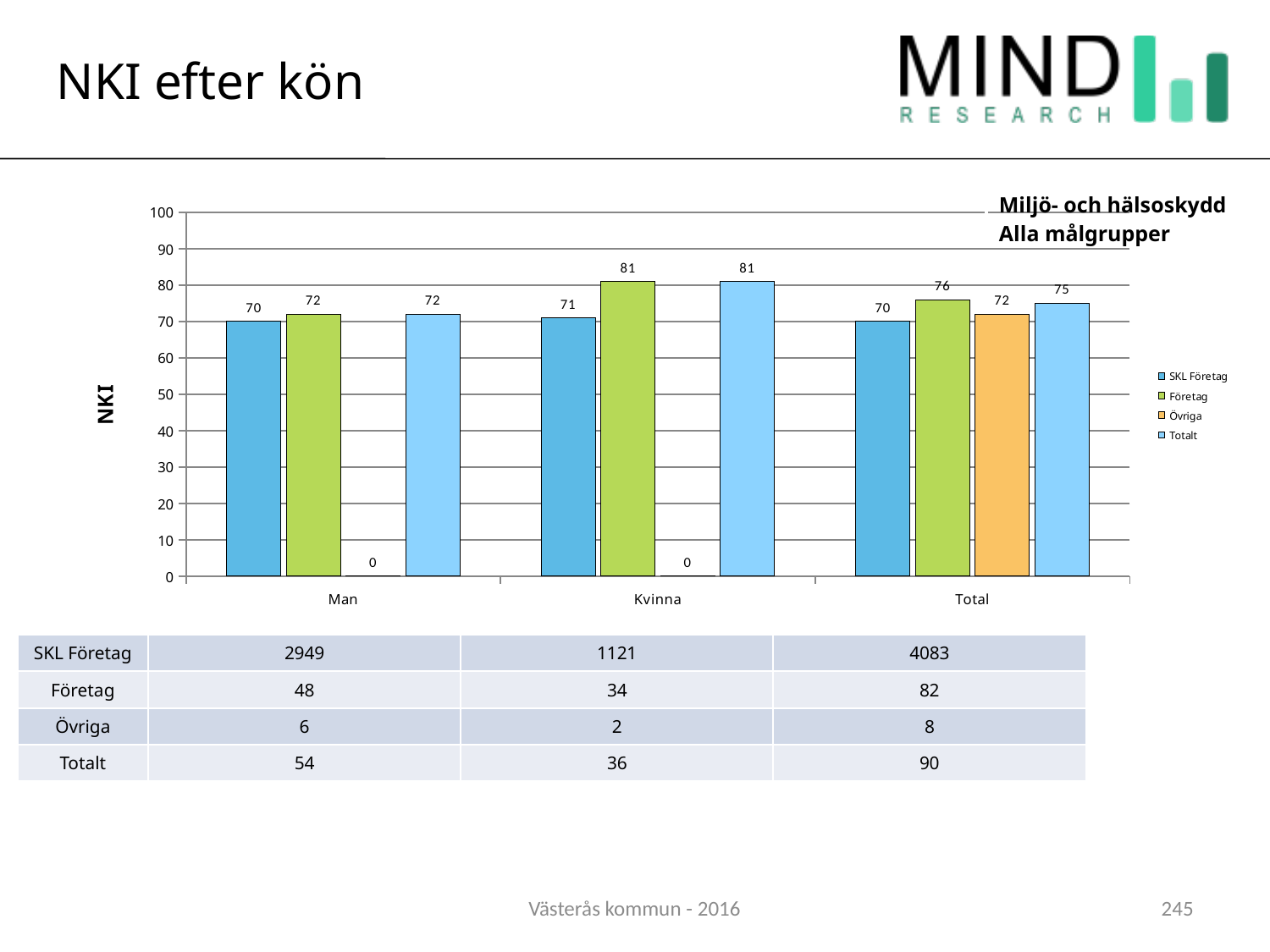
What is the NKI value for Företag in the Kvinna category? 81 What is the difference between the Företag values for Kvinna and Man? 9 What kind of chart is shown on the slide? bar chart What is the label on the vertical axis of the chart? NKI Which category has the highest Företag value? Kvinna Which series has the lowest value in the Man category? Övriga What is the NKI value for Övriga in the Total category? 72 What is the NKI value for SKL Företag in the Man category? 70 What is the NKI value for Totalt in the Total category? 75 How many series does the legend list? 4 Which is larger, the Totalt value for Kvinna or the Totalt value for Total? Kvinna How many categories are shown on the x axis? 3